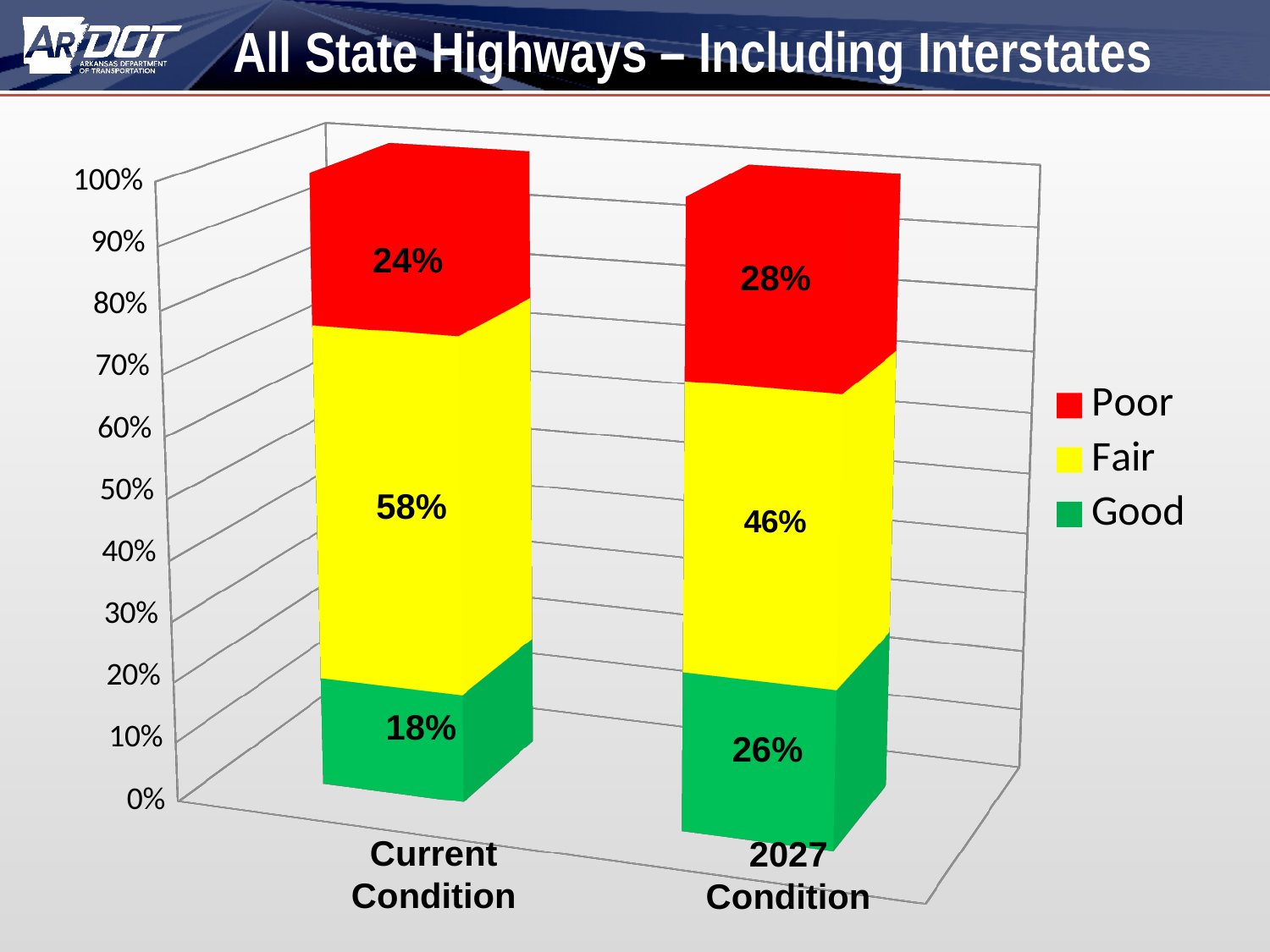
How many categories are shown on the x axis? 2 How many series does the legend list? 3 What is the difference between the Fair share in Current Condition and in 2027 Condition? 12% What kind of chart is shown on the slide? Stacked bar chart What is the Fair share for 2027 Condition? 46% Which category has the larger Good share, Current Condition or 2027 Condition? 2027 Condition What percentage of highways is in Good condition under 2027 Condition? 26% What is the Fair share for Current Condition? 58% What is the difference between the Poor share in 2027 Condition and in Current Condition? 4% What percentage of highways is in Poor condition under Current Condition? 24% What is the title of the chart? All State Highways – Including Interstates Which category has the larger Fair share, Current Condition or 2027 Condition? Current Condition